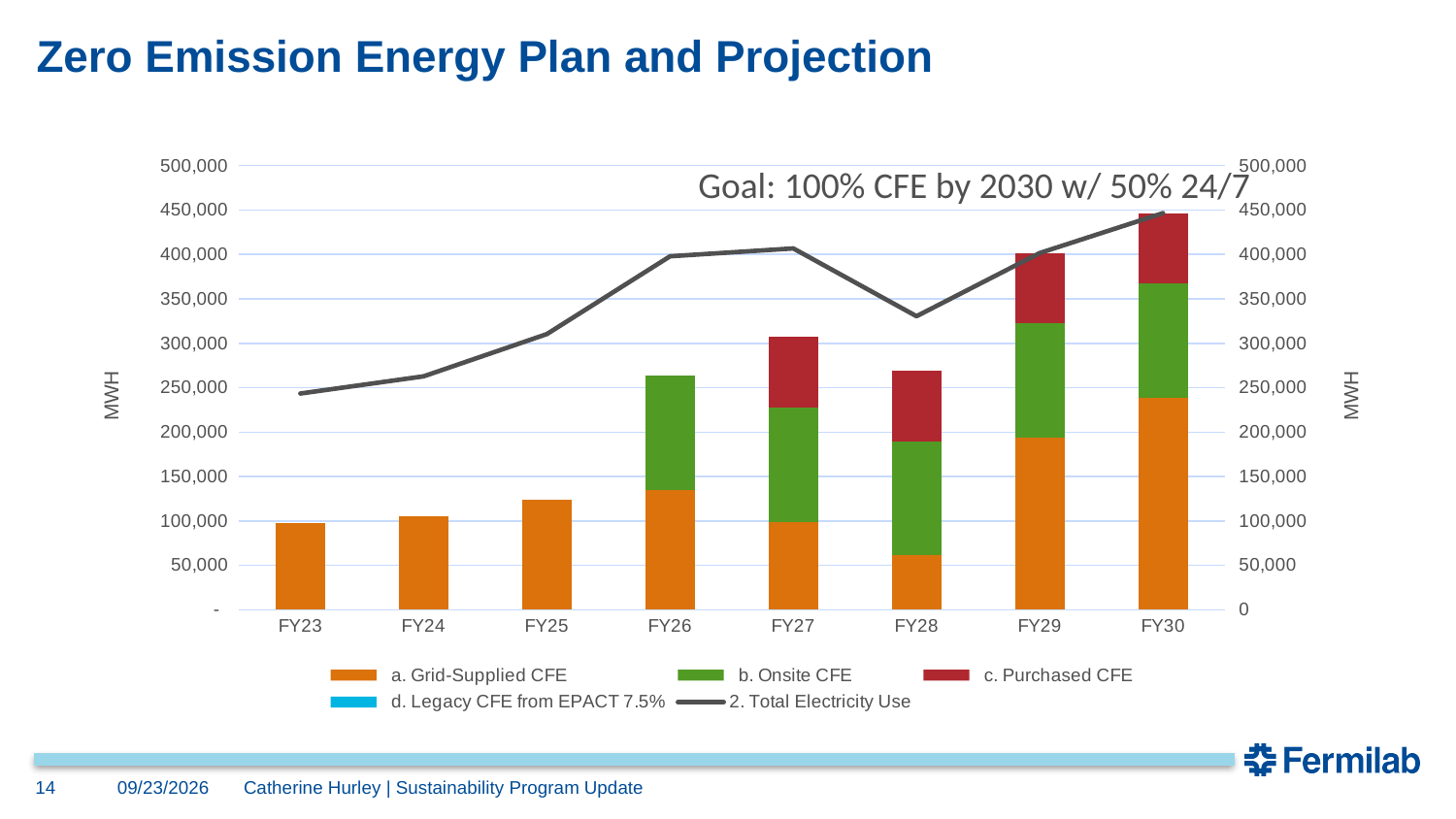
What kind of chart is shown on the slide? A stacked bar chart combined with a line chart What goal text is printed inside the chart area? Goal: 100% CFE by 2030 w/ 50% 24/7 Which is larger, the a. Grid-Supplied CFE segment in FY27 or in FY28? FY27 Which fiscal year has the shortest stacked bar? FY23 How many series does the chart's legend list? 5 Which fiscal year has the tallest stacked bar? FY30 Is the total stacked bar for FY30 greater or less than 400,000? greater How many fiscal years are shown on the x axis of the chart? 8 Is the value for a. Grid-Supplied CFE in FY25 greater or less than 100,000? greater Does the 2. Total Electricity Use line rise or fall between FY27 and FY28? fall Is the 2. Total Electricity Use line value for FY28 greater or less than 350,000? less